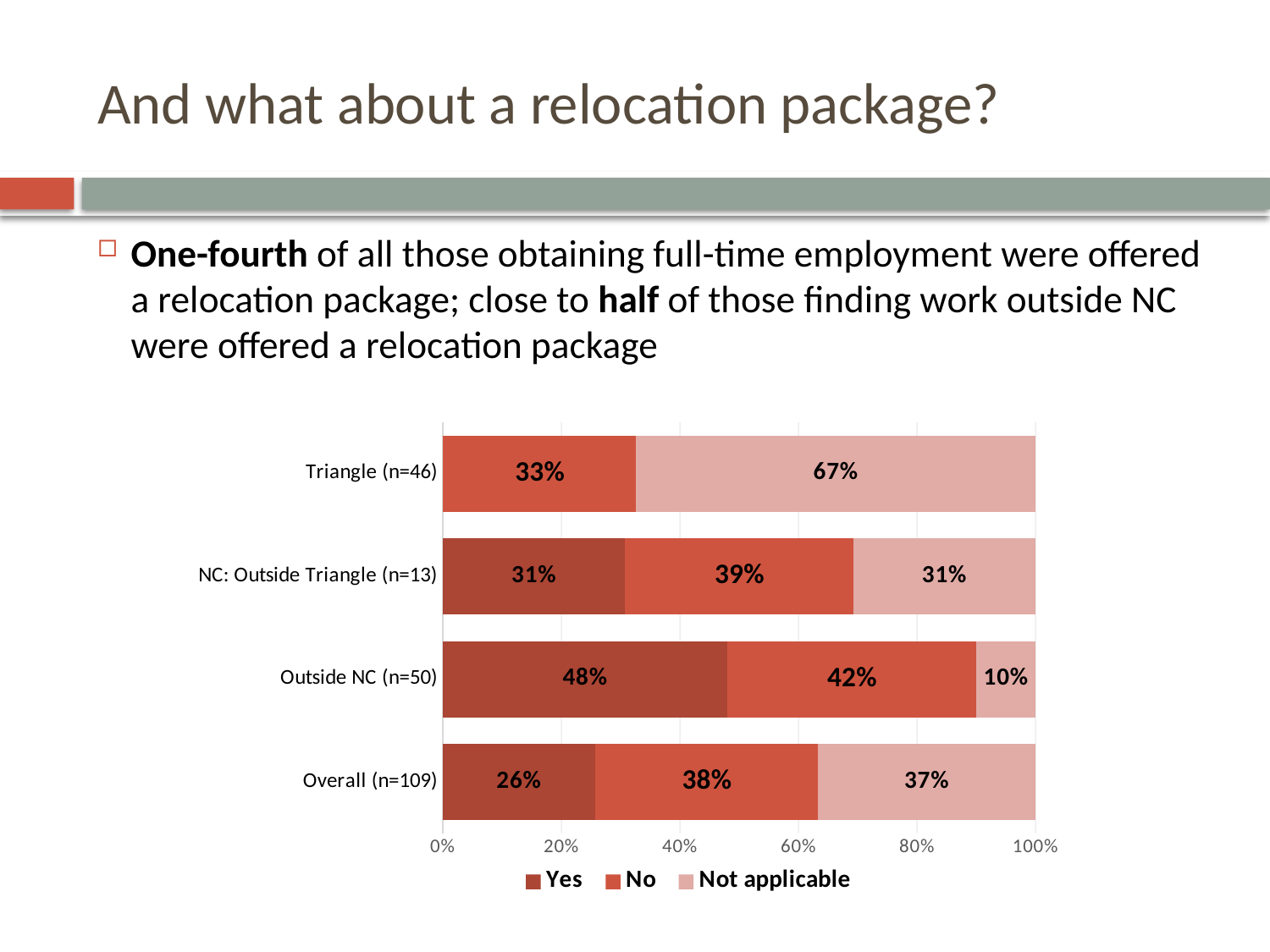
What percentage of the Overall (n=109) group answered No? 38% How many groups (bars) are shown in the chart? 4 For Outside NC (n=50), how many percentage points higher is Yes than No? 6 percentage points What is the No value for NC: Outside Triangle (n=13)? 39% What type of chart is shown on the slide? Stacked bar chart What is the Not applicable share for Triangle (n=46)? 67% For Triangle (n=46), what is the difference between the Not applicable share and the 33% share? 34 percentage points How many series does the legend list? 3 For Overall (n=109), which is larger: the No share or the Not applicable share? No Which group has the highest Yes percentage? Outside NC (n=50) What percentage of the Outside NC (n=50) group answered Yes? 48% Which group has the lowest Not applicable percentage? Outside NC (n=50)